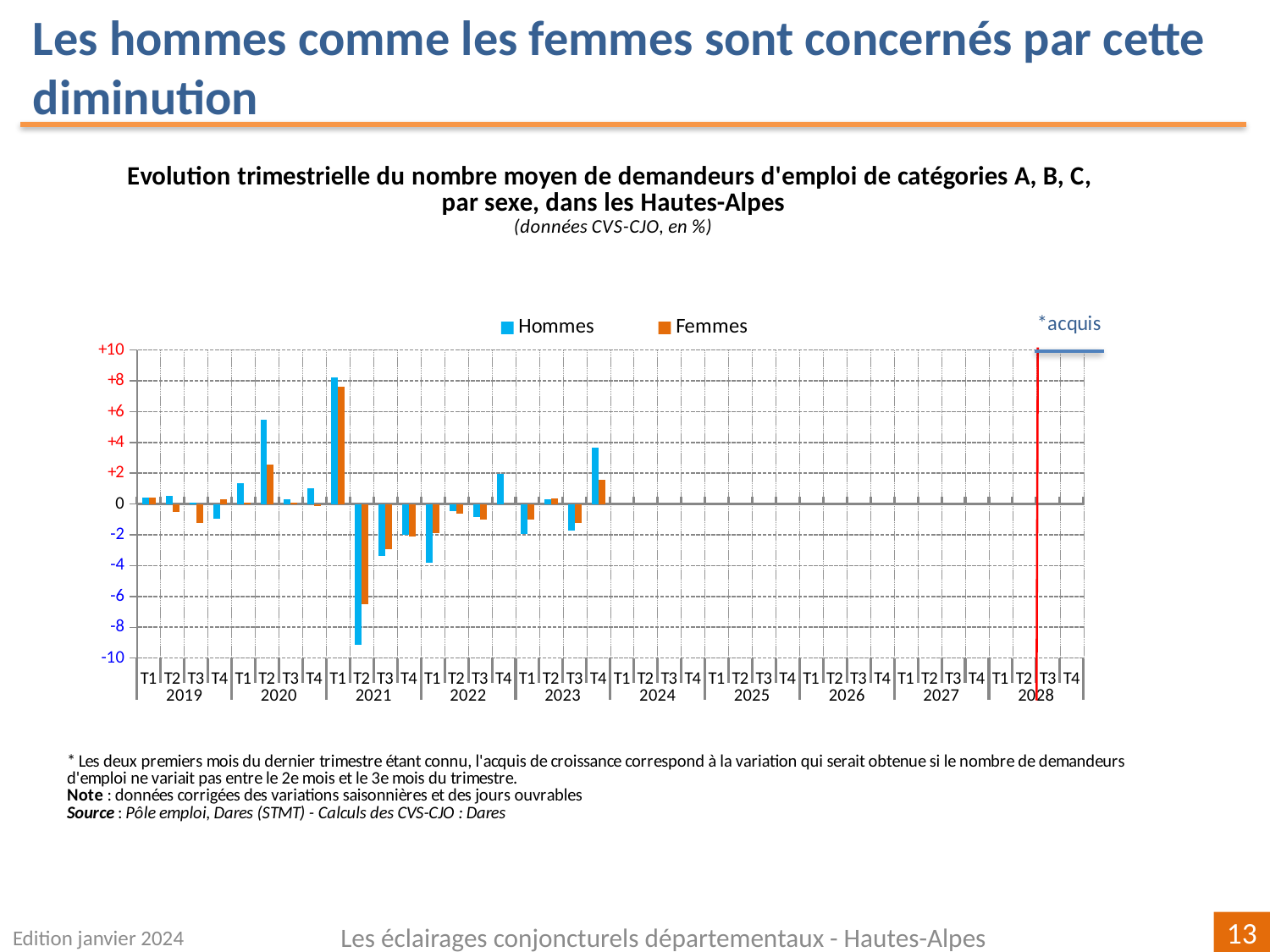
How many series does the legend list? 2 Is the Hommes value for T2 2021 greater or less than -8? less How many years are labelled along the x axis? 10 In which quarter is the Hommes value the highest? T1 2021 Which two series are shown in the legend? Hommes and Femmes Is the Hommes value for T2 2020 greater or less than +4? greater In T2 2020, which series has the larger value, Hommes or Femmes? Hommes What colour represents the Femmes series? Orange Is the Femmes value for T1 2021 greater or less than +6? greater In which quarter is the Femmes value the lowest? T2 2021 In which quarter is the Hommes value the lowest? T2 2021 What kind of chart is shown on the slide? Bar chart